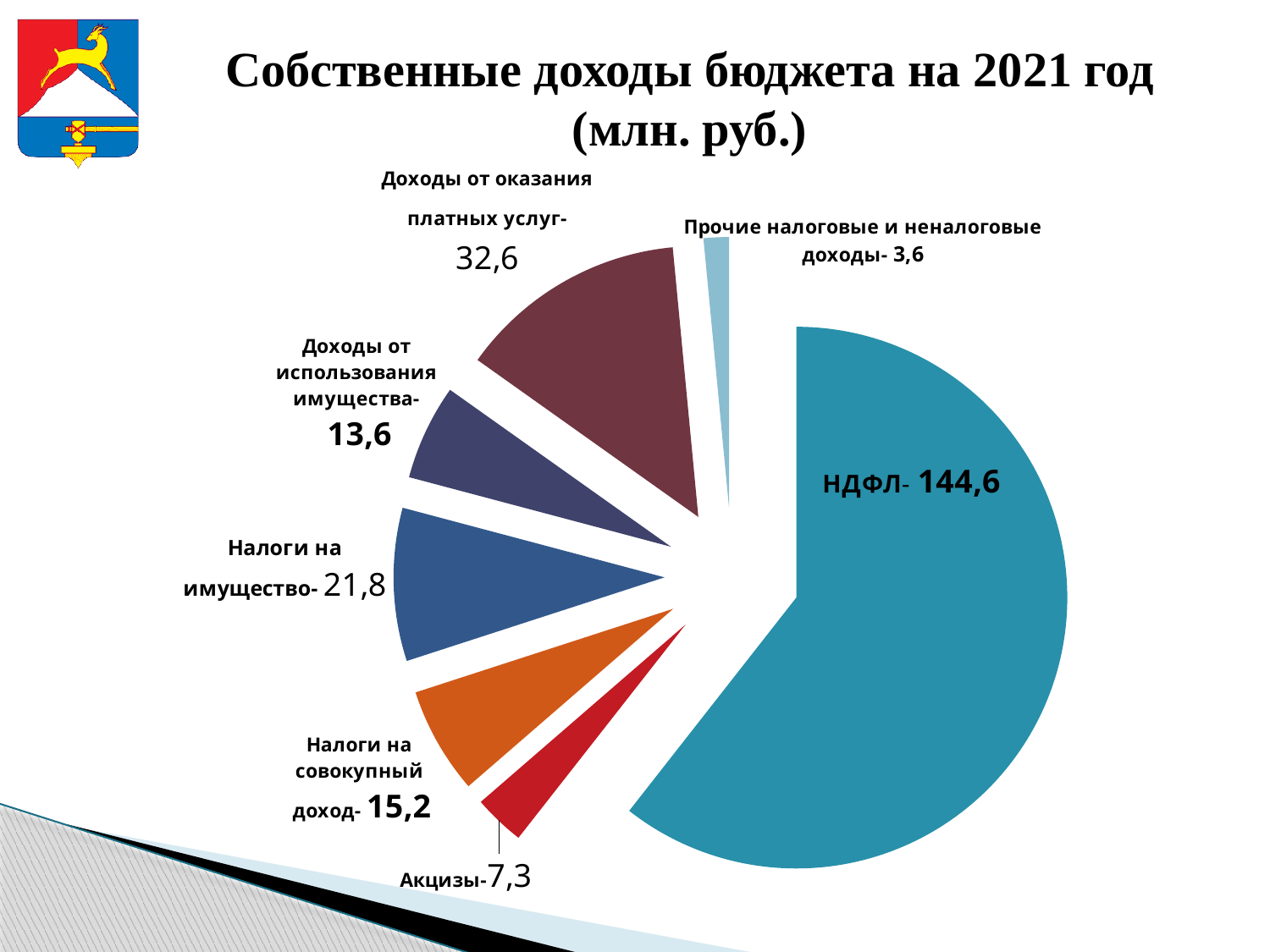
What kind of chart is shown on the slide? Pie chart What is the difference between Налоги на имущество and Налоги на совокупный доход? 6,6 What is the value for Доходы от оказания платных услуг? 32,6 Which is larger: Налоги на имущество or Доходы от использования имущества? Налоги на имущество How many categories are shown in the pie chart? 7 What is the value for Акцизы? 7,3 What is the title of the chart? Собственные доходы бюджета на 2021 год (млн. руб.) What is the value for Прочие налоговые и неналоговые доходы? 3,6 What is the value for НДФЛ? 144,6 Which category has the smallest slice of the pie? Прочие налоговые и неналоговые доходы What is the difference between НДФЛ and Доходы от оказания платных услуг? 112 Which category has the largest slice of the pie? НДФЛ